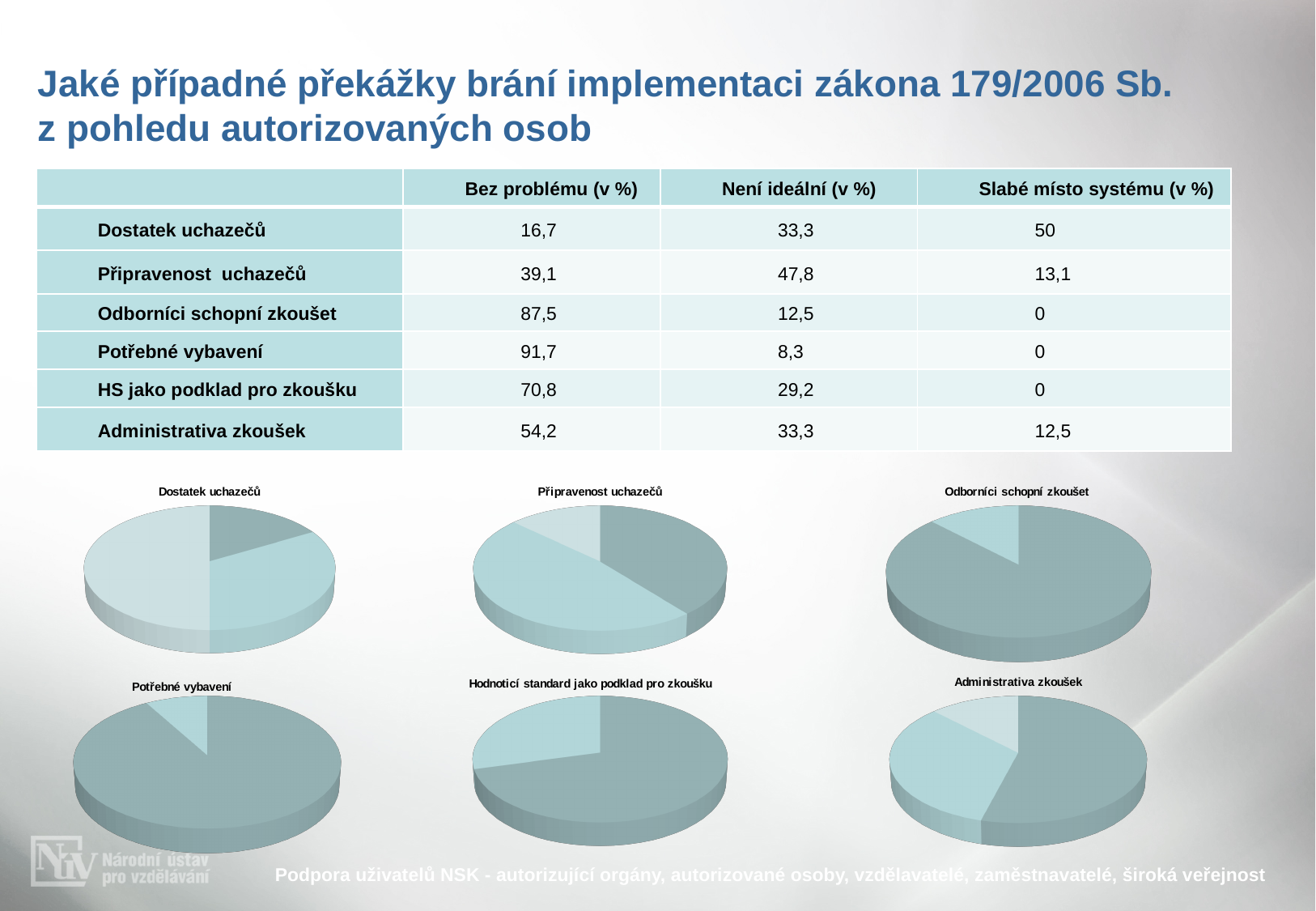
What kind of chart is used for "Dostatek uchazečů"? pie chart Is the "Bez problému" slice larger in the "Odborníci schopní zkoušet" chart or in the "Administrativa zkoušek" chart? Odborníci schopní zkoušet In the "Potřebné vybavení" chart, how many slices are visible? 2 How many pie charts are shown on the slide? 6 In the "Dostatek uchazečů" chart, what share is "Slabé místo systému"? 50 Which pie chart has the smallest "Bez problému" slice? Dostatek uchazečů In the "Administrativa zkoušek" chart, what share is "Slabé místo systému"? 12,5 In the "Připravenost uchazečů" chart, what share is "Není ideální"? 47,8 Which pie chart has the largest "Bez problému" slice? Potřebné vybavení In the "Administrativa zkoušek" chart, what is the difference between the "Bez problému" and "Není ideální" shares? 20,9